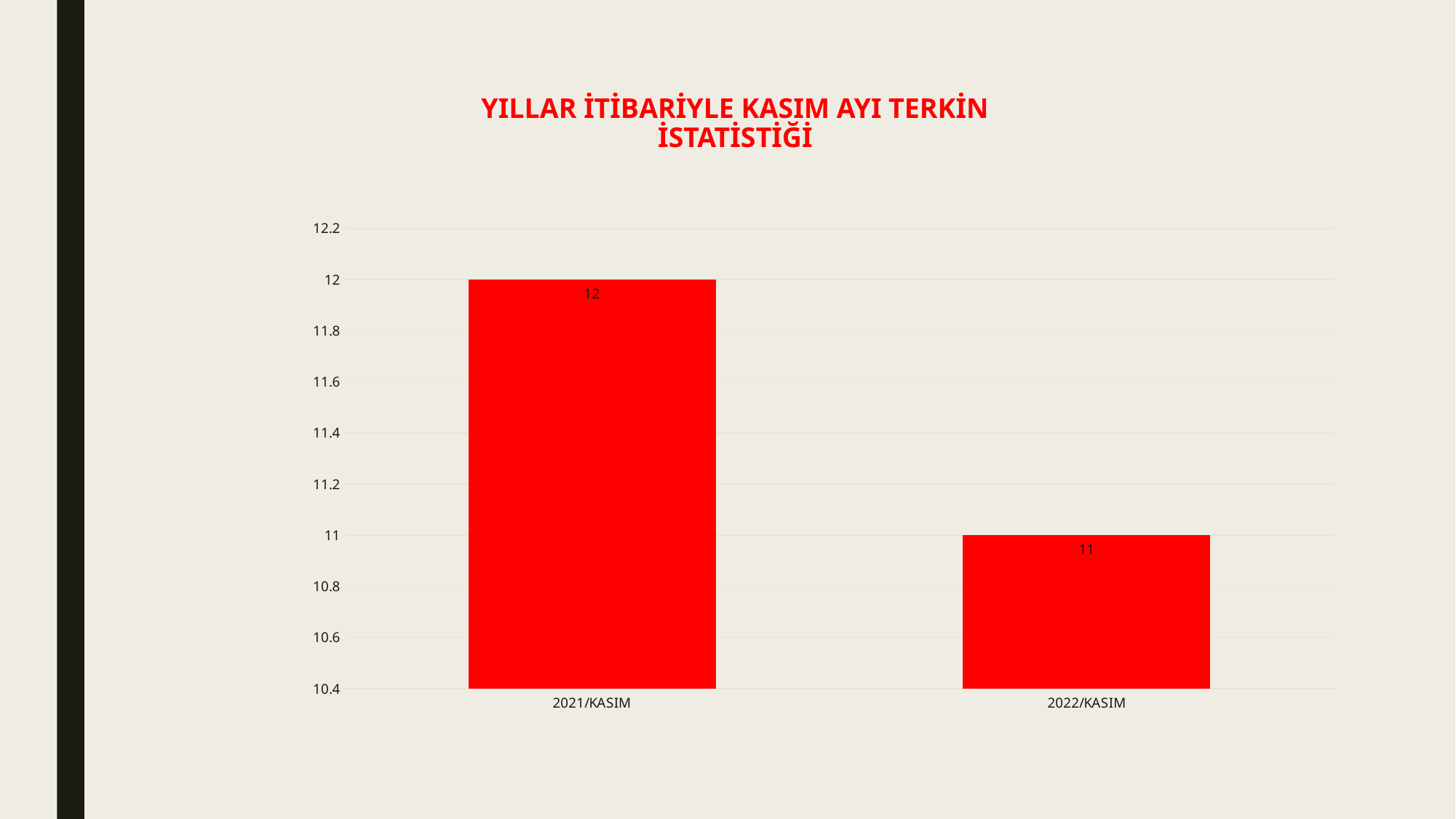
What is the value for 2021/KASIM? 12 Which category has the highest value? 2021/KASIM Which is larger, the value for 2021/KASIM or the value for 2022/KASIM? 2021/KASIM What is the title of the chart? YILLAR İTİBARİYLE KASIM AYI TERKİN İSTATİSTİĞİ Is the value for 2021/KASIM greater or less than 11.6? greater How many categories are shown on the x axis? 2 Is the value for 2022/KASIM greater or less than 11.4? less What is the difference between the values for 2021/KASIM and 2022/KASIM? 1 Do the values rise or fall from 2021/KASIM to 2022/KASIM? fall What is the value for 2022/KASIM? 11 Which category has the lowest value? 2022/KASIM What kind of chart is shown on the slide? bar chart